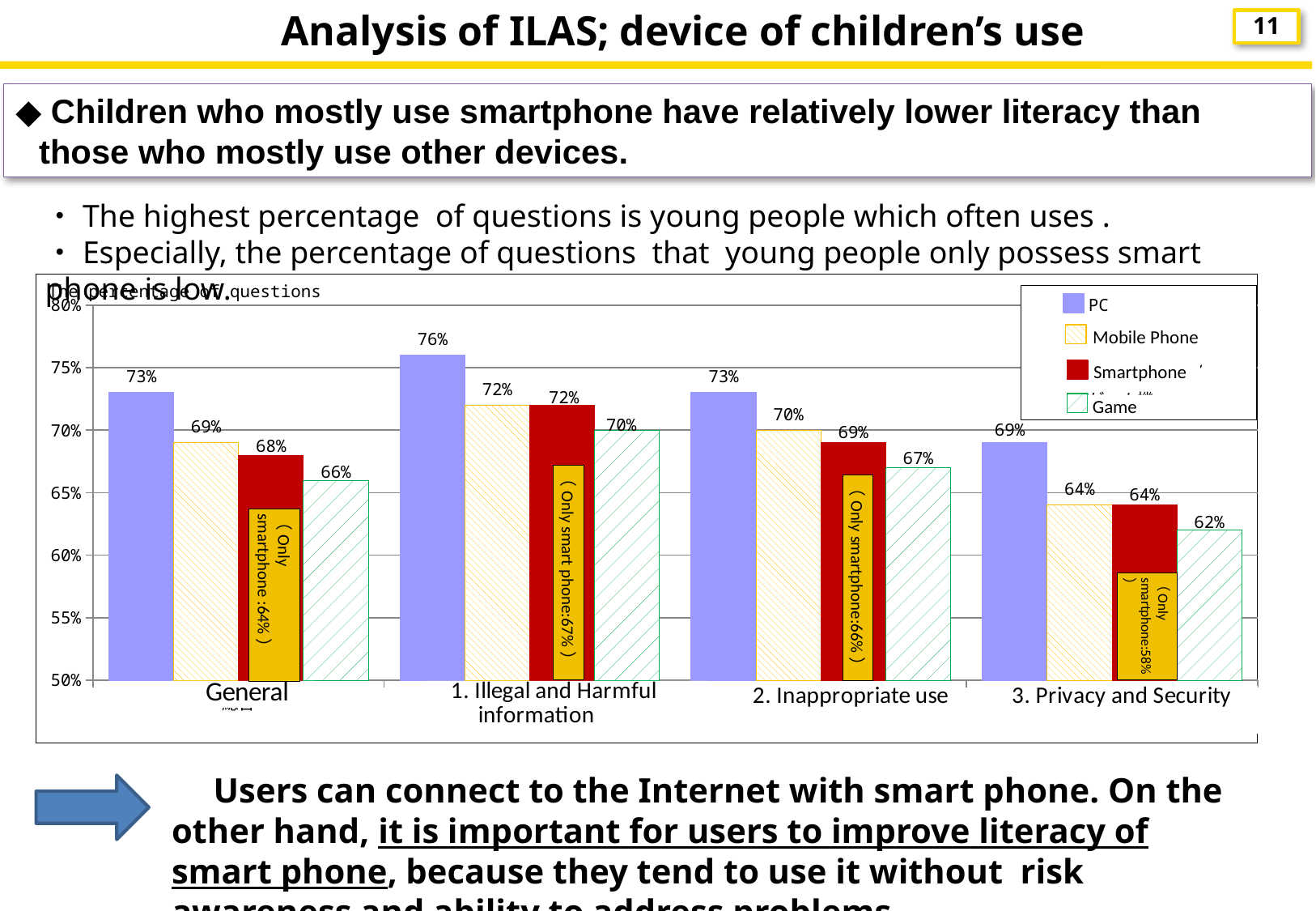
What is the 'Only smartphone' value shown inside the Smartphone bar for the '3. Privacy and Security' category? 58% What is the value for Game in the '3. Privacy and Security' category? 62% Which series has the lowest value in the '2. Inappropriate use' category? Game Which series has the highest value in the 'General' category? PC Across the four categories, does the PC value rise or fall from '2. Inappropriate use' to '3. Privacy and Security'? fall What kind of chart is shown on the slide? bar chart What is the value for PC in the '1. Illegal and Harmful information' category? 76% What is the value for Mobile Phone in the '2. Inappropriate use' category? 70% How many series does the chart legend list? 4 How many categories are shown along the x axis of the chart? 4 What is the difference between the PC value and the Game value in the 'General' category? 7% Which is larger in the '3. Privacy and Security' category: the PC value or the Smartphone value? PC